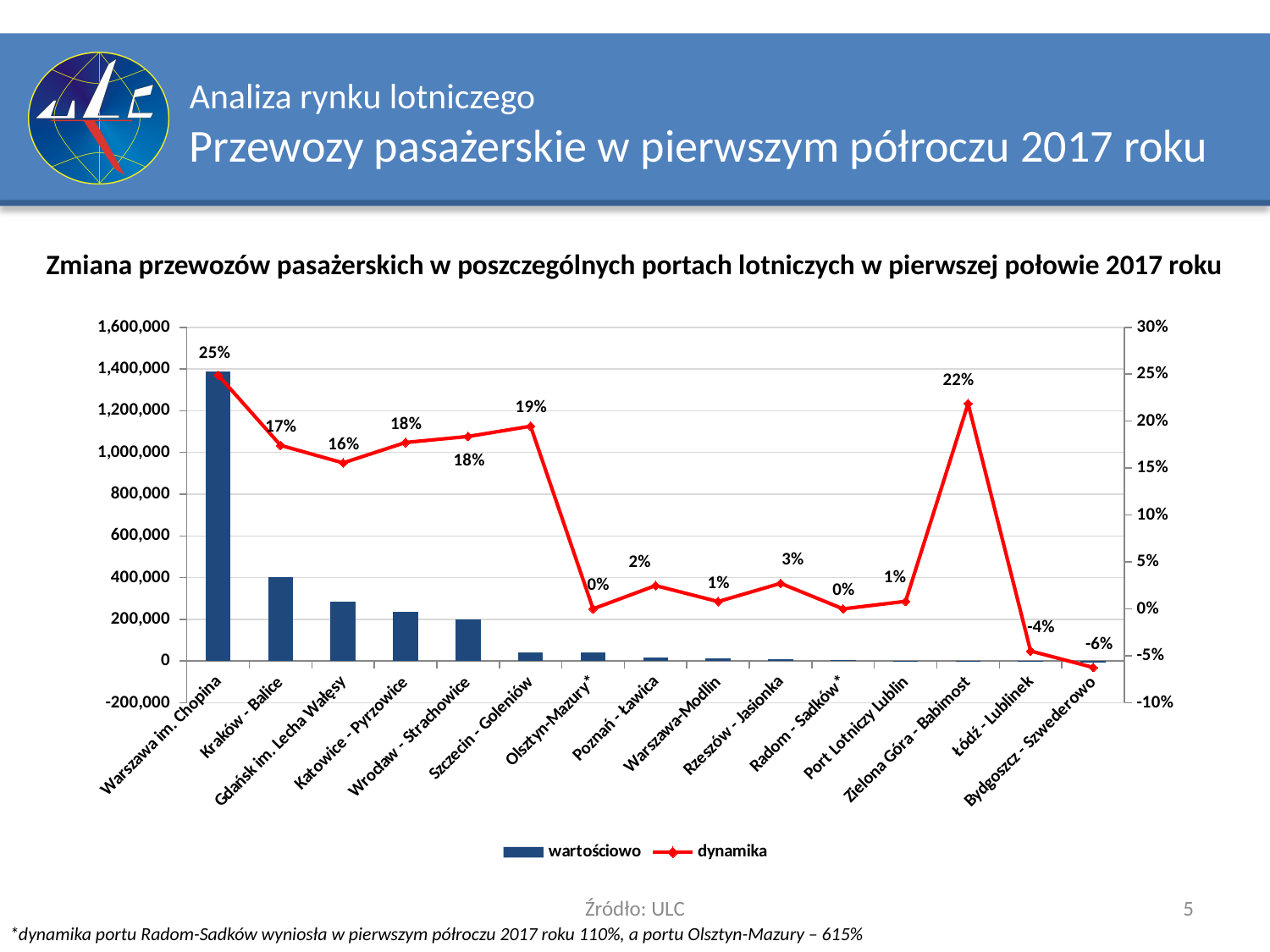
What is the dynamika value for Łódź - Lublinek? -4% How many series does the legend list? 2 What kind of chart is shown on the slide? A combination bar and line chart How many airports are shown on the x axis? 15 What is the dynamika value for Warszawa im. Chopina? 25% Which airport has the lowest dynamika value? Bydgoszcz - Szwederowo What is the difference in dynamika between Warszawa im. Chopina and Zielona Góra - Babimost? 3 percentage points Which has the higher dynamika value, Kraków - Balice or Gdańsk im. Lecha Wałęsy? Kraków - Balice Is the wartościowo bar for Warszawa im. Chopina greater or less than 1,200,000? greater Which airport has the highest dynamika value? Warszawa im. Chopina What is the dynamika value for Zielona Góra - Babimost? 22% What is the dynamika value for Bydgoszcz - Szwederowo? -6%